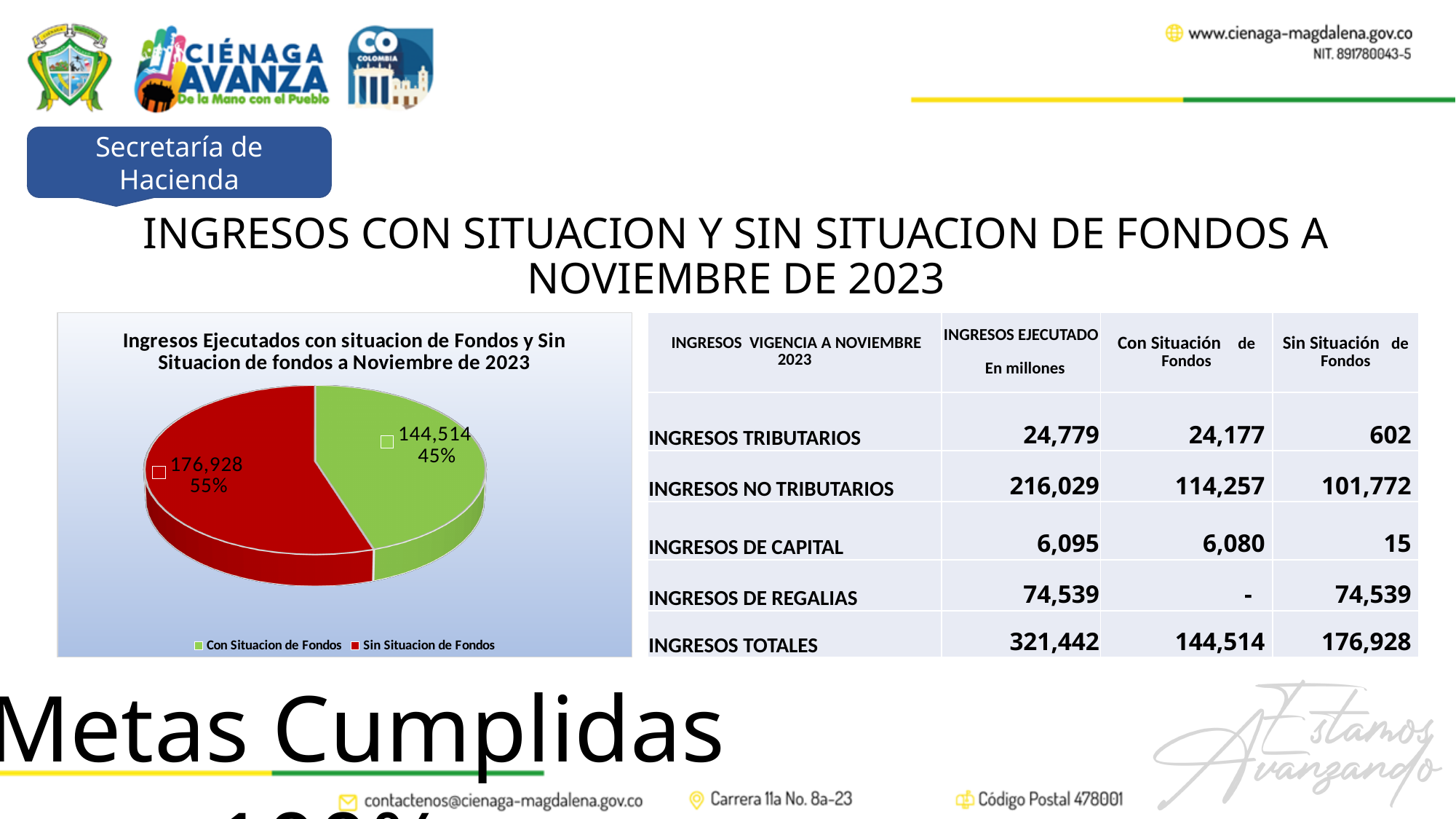
How many slices does the pie chart have? 2 What percentage share does Con Situacion de Fondos have in the pie chart? 45% Which is larger in the pie chart, Con Situacion de Fondos or Sin Situacion de Fondos? Sin Situacion de Fondos What is the difference between the Sin Situacion de Fondos value and the Con Situacion de Fondos value in the pie chart? 32,414 Which slice of the pie chart is the smallest? Con Situacion de Fondos What is the title of the pie chart? Ingresos Ejecutados con situacion de Fondos y Sin Situacion de fondos a Noviembre de 2023 What kind of chart is shown on the slide? Pie chart What percentage share does Sin Situacion de Fondos have in the pie chart? 55% What is the value for Sin Situacion de Fondos in the pie chart? 176,928 Which slice of the pie chart is the largest? Sin Situacion de Fondos What is the value for Con Situacion de Fondos in the pie chart? 144,514 What colour is the Sin Situacion de Fondos slice in the pie chart? Red